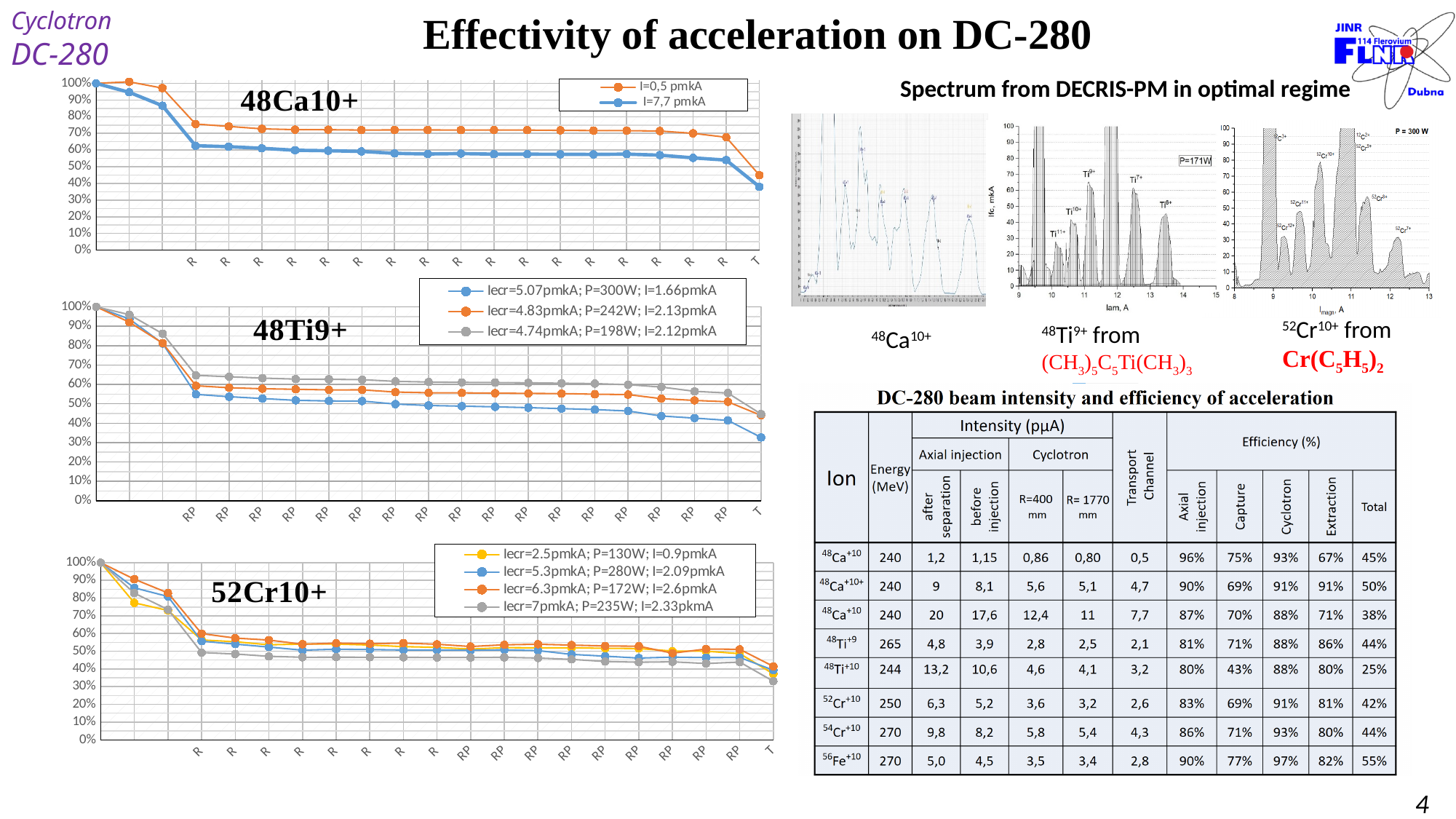
In the 48Ti9+ chart, is the final value (at T) of the Iecr=5.07pmkA; P=300W; I=1.66pmkA series greater or less than 40%? less What kind of chart is the 48Ca10+ chart? line chart In the 48Ca10+ chart, what is the value of both series at the first point on the x axis? 100% In the 48Ca10+ chart, which series has the higher values along the plateau: I=0,5 pmkA or I=7,7 pmkA? I=0,5 pmkA How many series does the legend of the 52Cr10+ chart list? 4 In the 48Ca10+ chart, is the plateau value of the I=7,7 pmkA series greater or less than 70%? less In the 48Ti9+ chart, which series has the lowest values across the RP points? Iecr=5.07pmkA; P=300W; I=1.66pmkA In the 52Cr10+ chart, which series has the lowest values across the R and RP points? Iecr=7pmkA; P=235W; I=2.33pkmA How many series does the legend of the 48Ca10+ chart list? 2 What is the maximum value shown on the y axis of the 52Cr10+ chart? 100% How many series does the legend of the 48Ti9+ chart list? 3 In the 52Cr10+ chart, do the values rise or fall from the first point to the last point (T) along the x axis? fall